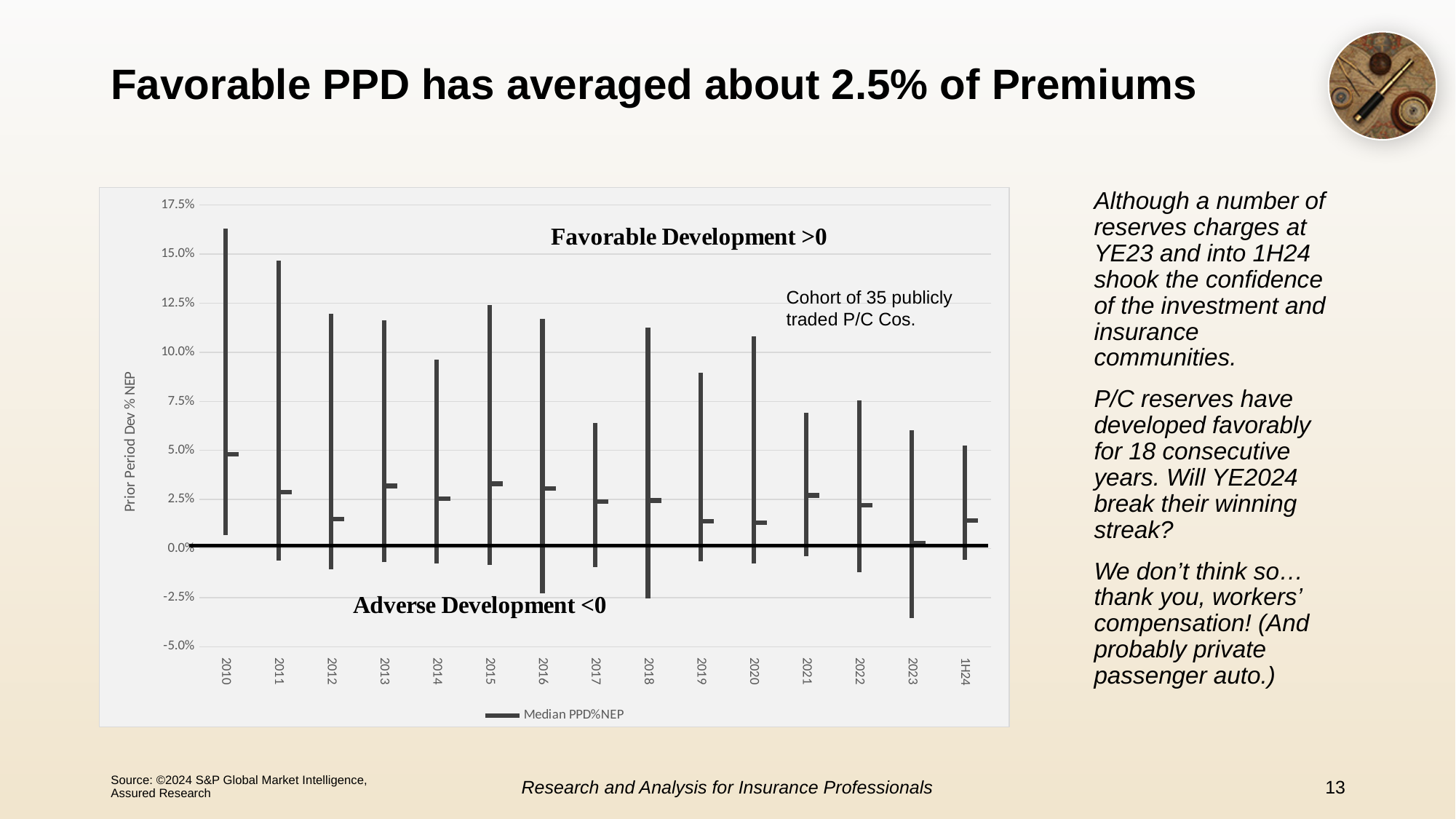
Which period has the lowest median PPD%NEP? 2023 Is the upper end of the range for 2016 greater or less than 10.0%? greater How many periods are shown along the x axis of the chart? 15 Is the median PPD%NEP for 2023 greater or less than 2.5%? less Which period has the highest median PPD%NEP? 2010 Is the median PPD%NEP for 2010 greater or less than 2.5%? greater How many series does the chart's legend list? 1 Which period has the lowest bottom end of its range? 2023 Which period has the highest upper end of its range? 2010 What is the label on the vertical axis of the chart? Prior Period Dev % NEP What entry does the chart's legend list? Median PPD%NEP